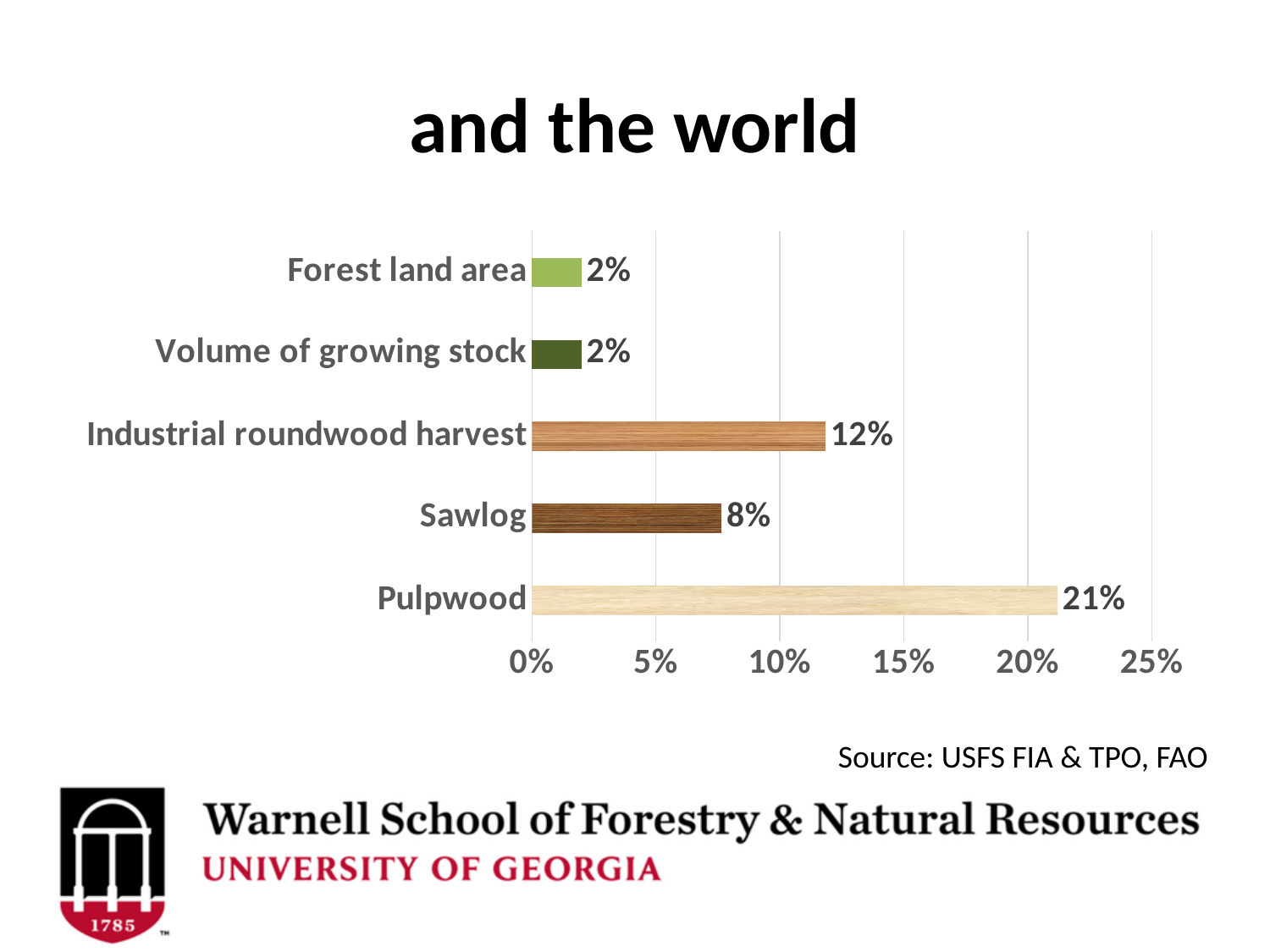
What is the source cited below the chart? USFS FIA & TPO, FAO What is the difference between the values for Industrial roundwood harvest and Forest land area? 10% What is the value for Forest land area? 2% What is the value for Industrial roundwood harvest? 12% What kind of chart is shown on the slide? bar chart What is the difference between the values for Pulpwood and Sawlog? 13% Which is larger, the value for Industrial roundwood harvest or the value for Sawlog? Industrial roundwood harvest Is the value for Pulpwood greater or less than 20%? greater What is the value for Sawlog? 8% How many categories are shown in the chart? 5 Which category has the highest value? Pulpwood What is the value for Pulpwood? 21%